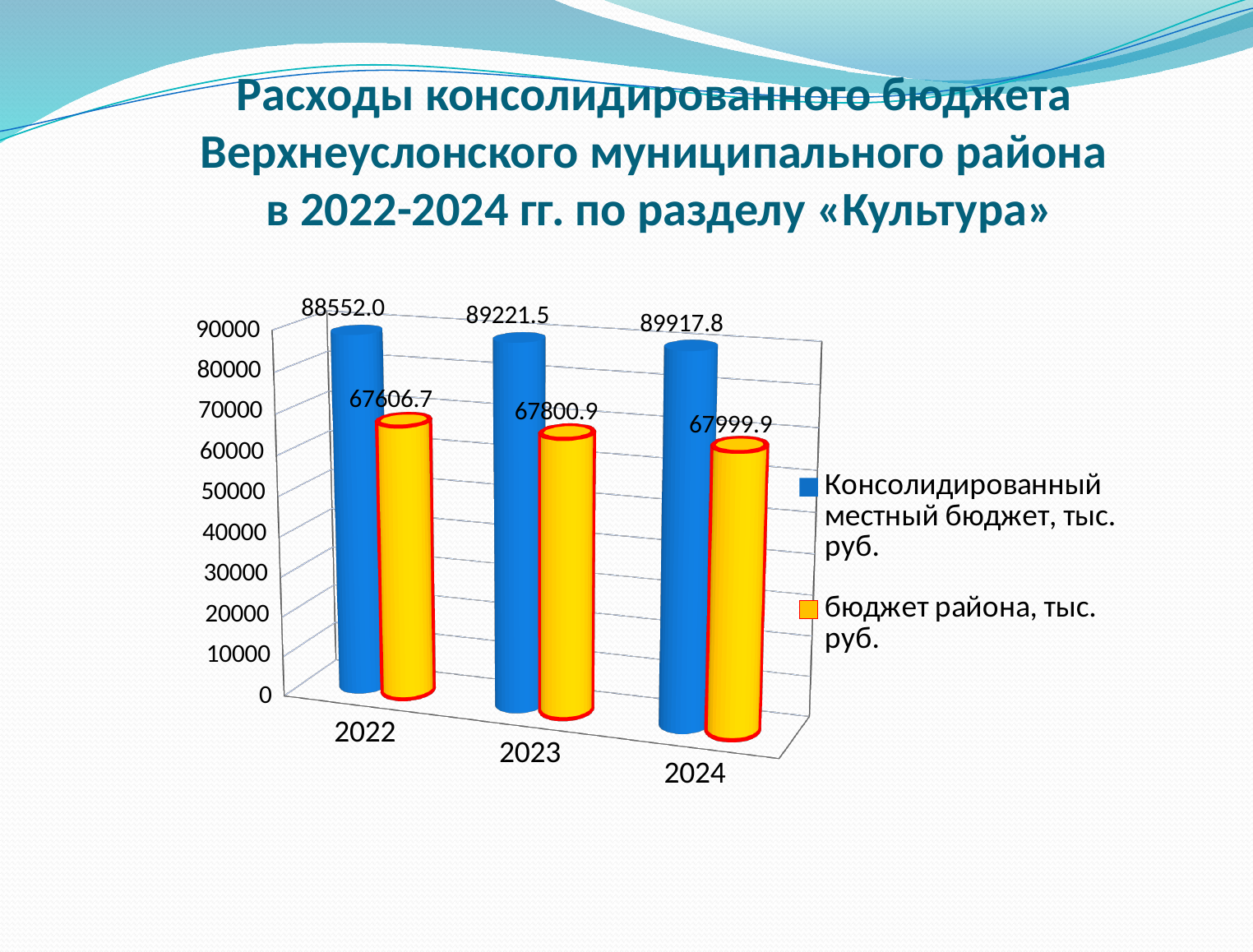
Do the 'бюджет района, тыс. руб.' values rise or fall from 2022 to 2024? rise What is the value of the 'Консолидированный местный бюджет, тыс. руб.' series for 2024? 89917.8 What is the value of the 'Консолидированный местный бюджет, тыс. руб.' series for 2022? 88552.0 Which is larger in 2023: the 'Консолидированный местный бюджет' value or the 'бюджет района' value? Консолидированный местный бюджет How many series does the chart legend list? 2 What is the value of the 'бюджет района, тыс. руб.' series for 2023? 67800.9 What is the value of the 'бюджет района, тыс. руб.' series for 2022? 67606.7 By how much did the 'Консолидированный местный бюджет, тыс. руб.' value increase from 2022 to 2024? 1365.8 What is the difference between the 'Консолидированный местный бюджет' and 'бюджет района' values in 2024? 21917.9 How many years are shown on the x axis of the chart? 3 In which year is the 'Консолидированный местный бюджет, тыс. руб.' value the highest? 2024 In which year is the 'бюджет района, тыс. руб.' value the lowest? 2022